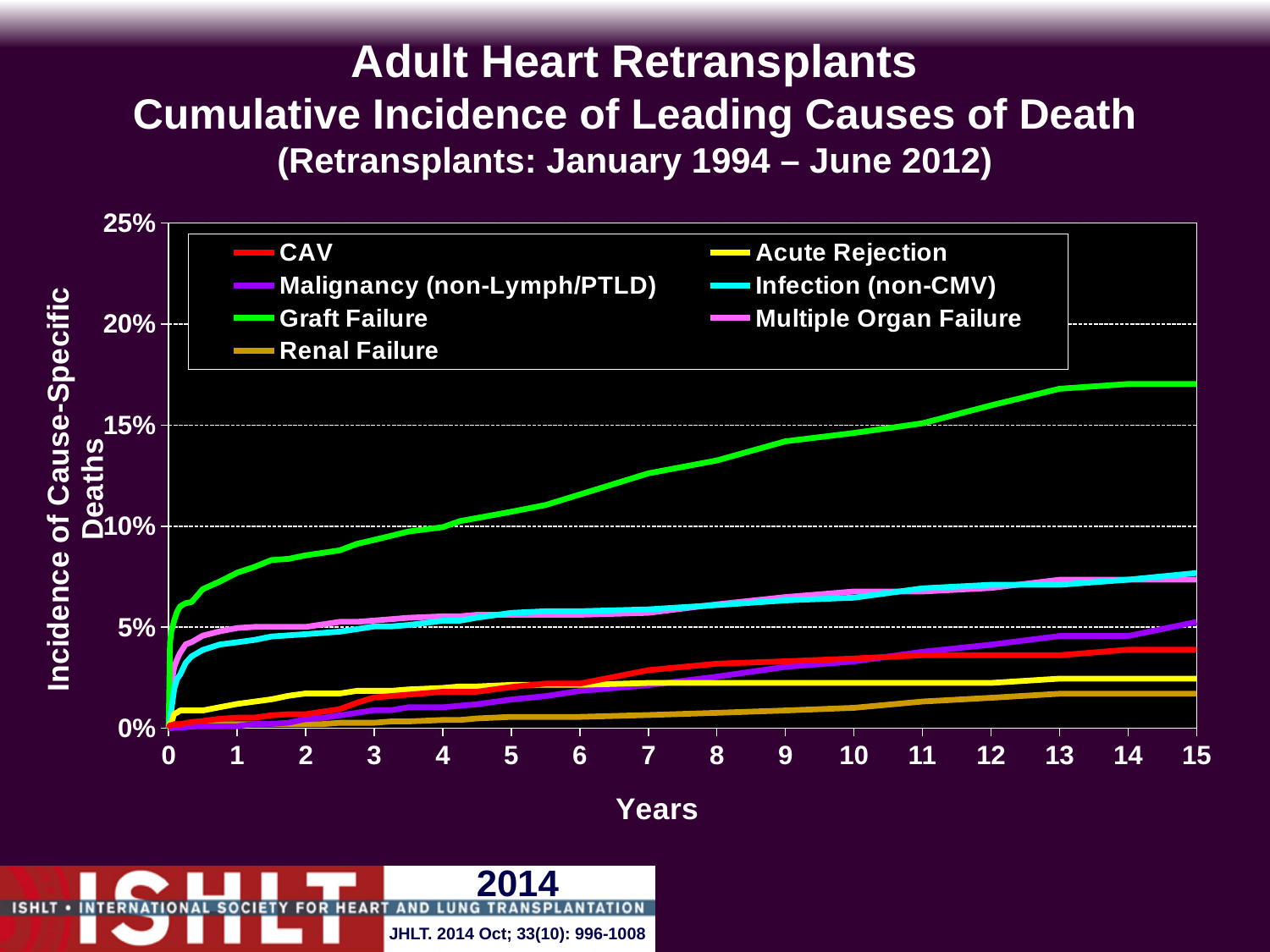
Which is larger at 15 years, the cumulative incidence for Graft Failure or for CAV? Graft Failure Is the cumulative incidence for Infection (non-CMV) at 15 years greater or less than 5%? greater Is the cumulative incidence for Graft Failure at 1 year greater or less than 10%? less How many series does the legend list? 7 What is the label of the x axis? Years Which cause of death has the highest cumulative incidence at 15 years? Graft Failure Which cause of death has the lowest cumulative incidence at 15 years? Renal Failure What kind of chart is shown on the slide? Line chart Does the cumulative incidence for Graft Failure rise or fall as years increase? Rise What colour is the Graft Failure line in the legend? Green Is the cumulative incidence for Graft Failure at 15 years greater or less than 15%? greater